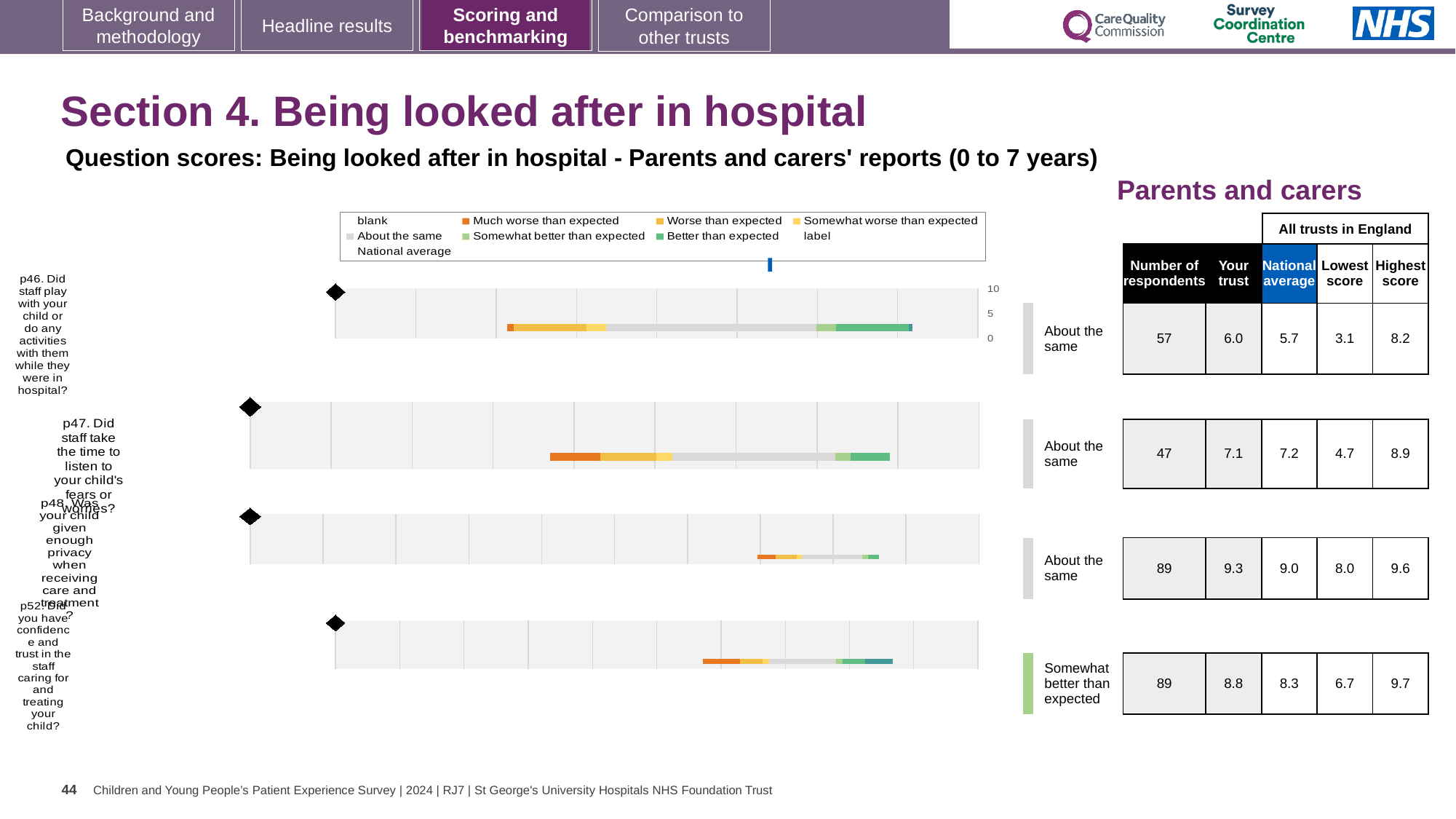
What is the 'Your trust' score for question p46 (Did staff play with your child or do any activities with them while they were in hospital?)? 6.0 What benchmark category is shown for question p52? Somewhat better than expected What is the national average score for question p47 (Did staff take the time to listen to your child's fears or worries?)? 7.2 How many survey questions are plotted on the slide? 4 What is the difference between the highest score and the lowest score for question p46? 5.1 What is the lowest score among all trusts in England for question p52? 6.7 What kind of chart is used to show the question scores on this slide? bar chart What is the highest score among all trusts in England for question p48 (Was your child given enough privacy when receiving care and treatment?)? 9.6 Which question has the highest 'Your trust' score? p48 For question p47, which is larger: the 'Your trust' score or the national average? National average How many respondents answered question p52 (Did you have confidence and trust in the staff caring for and treating your child?)? 89 Which question has the lowest 'Your trust' score? p46